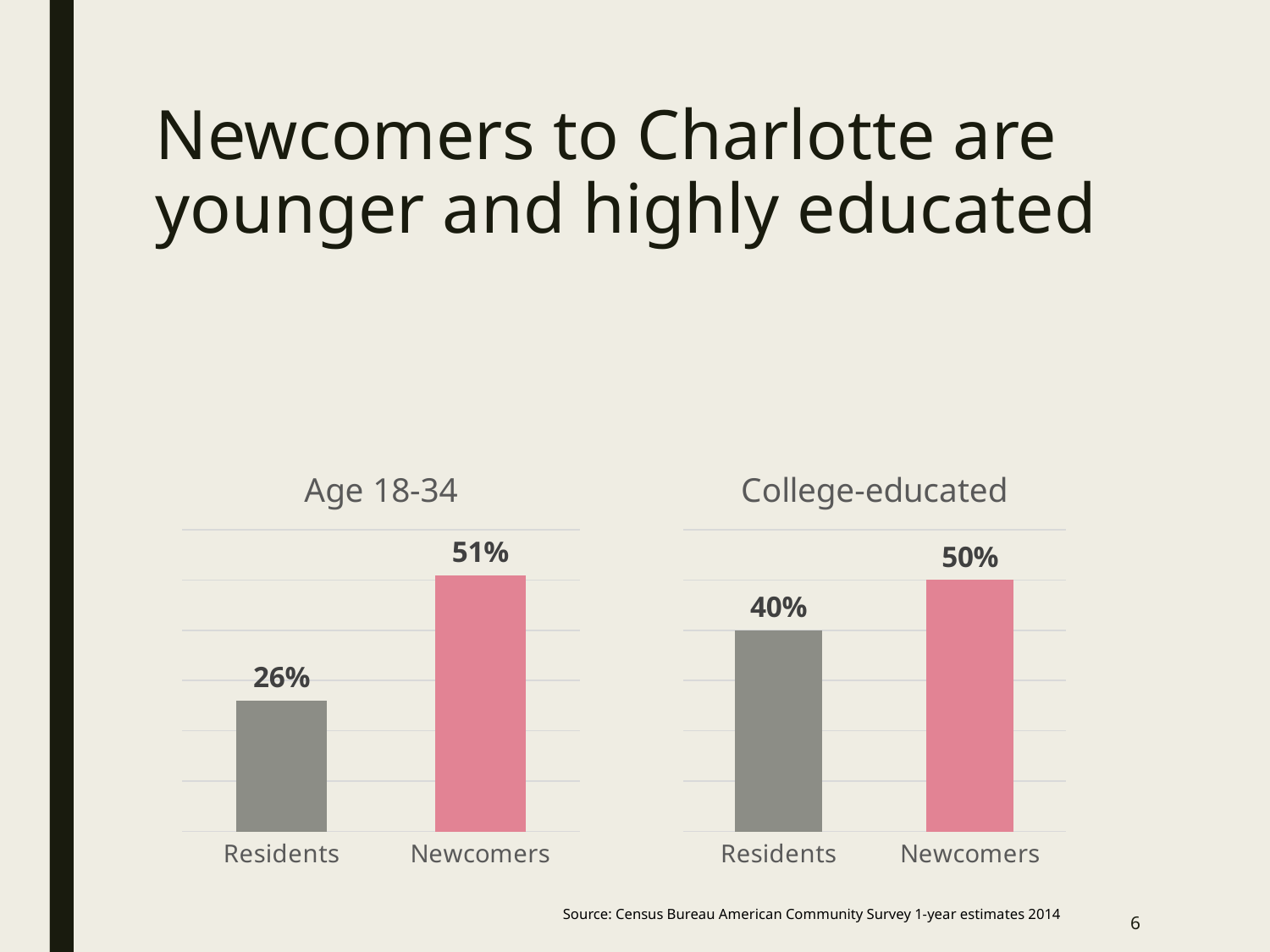
What is the title of the chart on the left side of the slide? Age 18-34 In the 'College-educated' chart, which is larger, the value for Residents or the value for Newcomers? Newcomers How many categories are shown in the 'Age 18-34' chart? 2 In the 'Age 18-34' chart, what is the value for Newcomers? 51% In the 'Age 18-34' chart, what is the value for Residents? 26% In the 'College-educated' chart, which category has the lowest value? Residents What kind of chart is the 'College-educated' chart? Bar chart In the 'Age 18-34' chart, which category has the highest value? Newcomers In the 'Age 18-34' chart, what is the difference between the Newcomers and Residents values? 25% In the 'College-educated' chart, what is the value for Residents? 40% In the 'College-educated' chart, what is the value for Newcomers? 50% In the 'College-educated' chart, what is the difference between the Newcomers and Residents values? 10%